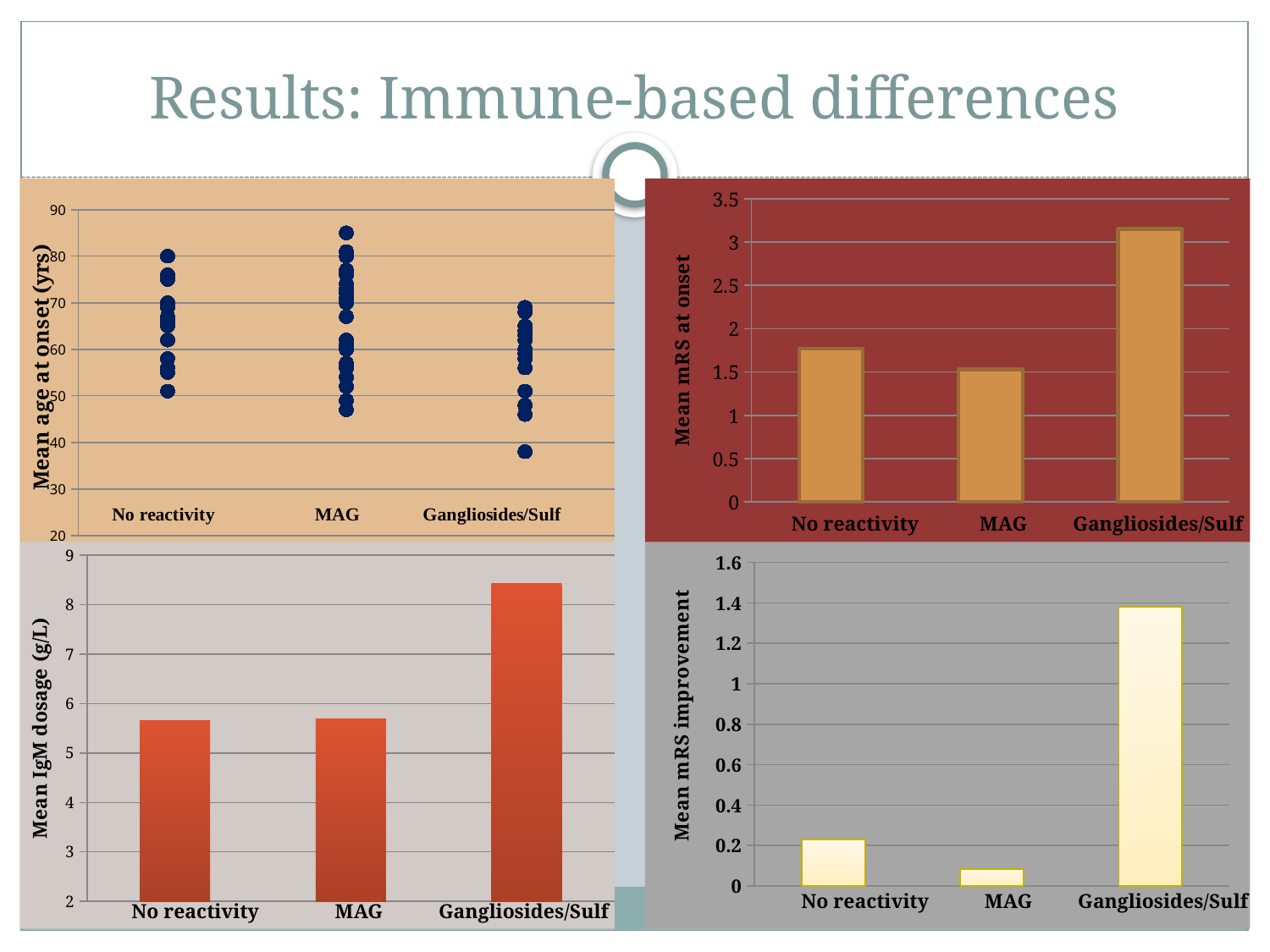
On the Mean IgM dosage chart (bottom left), which category has the highest value? Gangliosides/Sulf On the Mean IgM dosage chart (bottom left), is the value for Gangliosides/Sulf greater or less than 8? greater On the Mean IgM dosage chart (bottom left), is the value for No reactivity greater or less than 6? less On the Mean mRS improvement chart (bottom right), which is larger, the value for No reactivity or the value for MAG? No reactivity On the Mean mRS at onset chart (top right), which category has the highest value? Gangliosides/Sulf What kind of chart is the Mean age at onset chart (top left)? scatter chart On the Mean mRS at onset chart (top right), is the value for No reactivity greater or less than 2? less On the Mean mRS at onset chart (top right), which category has the lowest value? MAG On the Mean mRS improvement chart (bottom right), which category has the lowest value? MAG How many categories are shown on the x axis of the Mean IgM dosage chart (bottom left)? 3